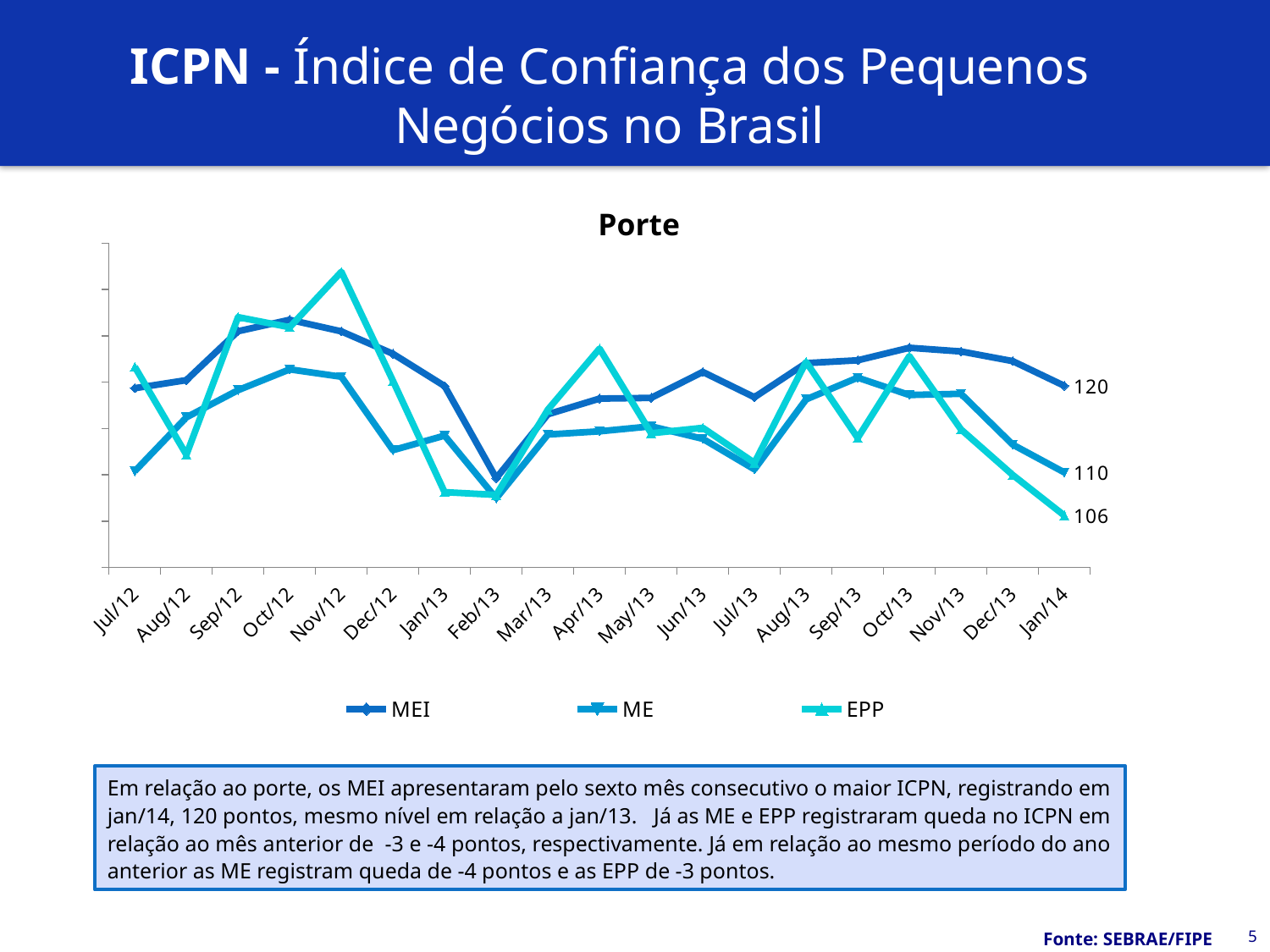
What is the value for MEI in Jan/14? 120 Does the EPP line rise or fall from Oct/13 to Jan/14? Fall What is the value for ME in Jan/14? 110 Which series has the highest value in Jan/14? MEI How many months are plotted along the x axis? 19 What is the difference between the MEI and ME values in Jan/14? 10 What is the difference between the ME and EPP values in Jan/14? 4 What is the title of the chart? Porte How many series does the legend list? 3 Which series has the lowest value in Jan/14? EPP What kind of chart is shown on the slide? Line chart What is the value for EPP in Jan/14? 106